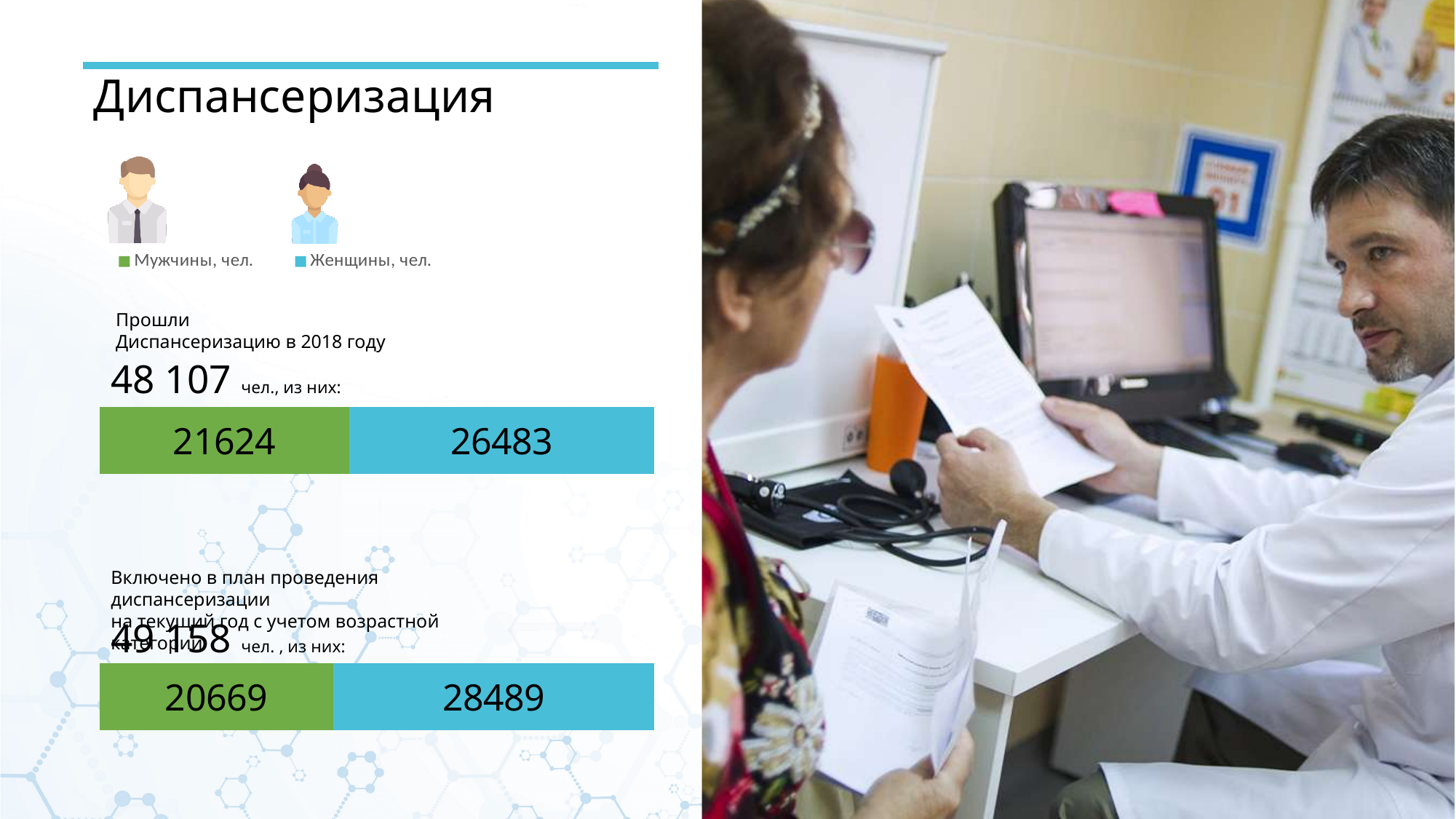
In the lower bar (Включено в план проведения диспансеризации на текущий год), what is the value for Мужчины, чел.? 20669 In the upper bar for 2018, what is the difference between the Женщины and Мужчины values? 4859 In the upper bar for 2018, which segment is larger, Мужчины or Женщины? Женщины What is the total of the upper stacked bar (Прошли диспансеризацию в 2018 году)? 48 107 In the lower bar (Включено в план проведения диспансеризации на текущий год), what is the value for Женщины, чел.? 28489 What is the total of the lower stacked bar (Включено в план проведения диспансеризации на текущий год)? 49 158 How many series does the legend list? 2 In the lower bar for the current year plan, what is the difference between the Женщины and Мужчины values? 7820 In the lower bar for the current year plan, which segment is larger, Мужчины or Женщины? Женщины In the upper bar (Прошли диспансеризацию в 2018 году), what is the value for Мужчины, чел.? 21624 In the upper bar (Прошли диспансеризацию в 2018 году), what is the value for Женщины, чел.? 26483 What colour represents Мужчины, чел. in the legend? Green